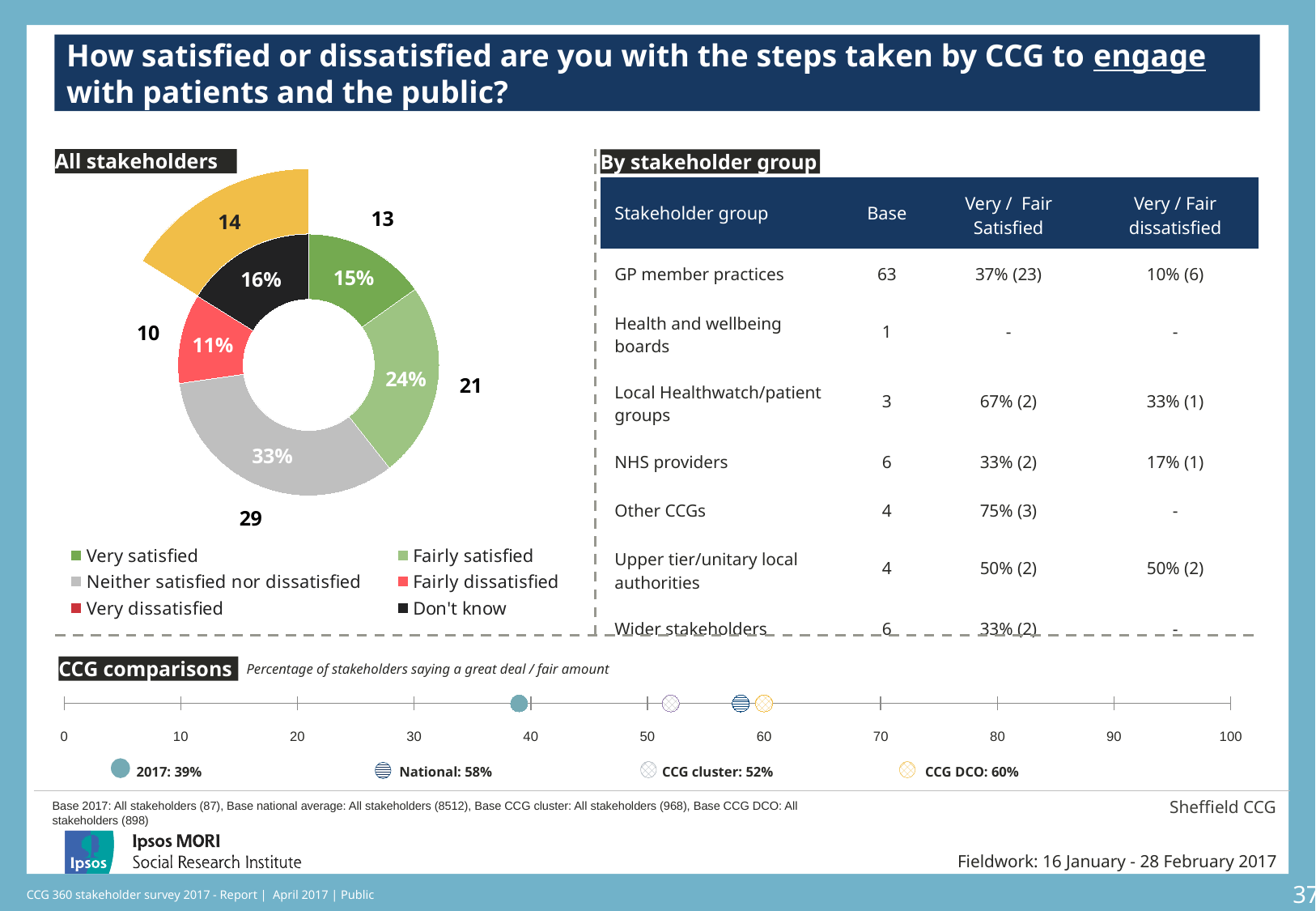
In the CCG comparisons chart, which of the four markers has the highest value? CCG DCO: 60% How many response categories does the legend of the All stakeholders chart list? 6 In the All stakeholders donut chart, what is the difference in percentage points between the fairly satisfied and very satisfied shares? 9 In the CCG comparisons chart, what is the difference in percentage points between the National value and the 2017 value? 19 In the All stakeholders donut chart, which response category has the largest share? Neither satisfied nor dissatisfied What type of chart is used for the All stakeholders results? Donut (pie) chart In the All stakeholders donut chart, which of the labelled slices has the smallest share? Fairly dissatisfied In the All stakeholders donut chart, what percentage of stakeholders are very satisfied? 15% In the All stakeholders donut chart, what percentage of stakeholders are neither satisfied nor dissatisfied? 33% In the All stakeholders donut chart, what percentage of stakeholders are fairly dissatisfied? 11% In the All stakeholders donut chart, which is larger: the Don't know share or the Fairly dissatisfied share? Don't know In the CCG comparisons chart, what is the 2017 value for this CCG? 39%